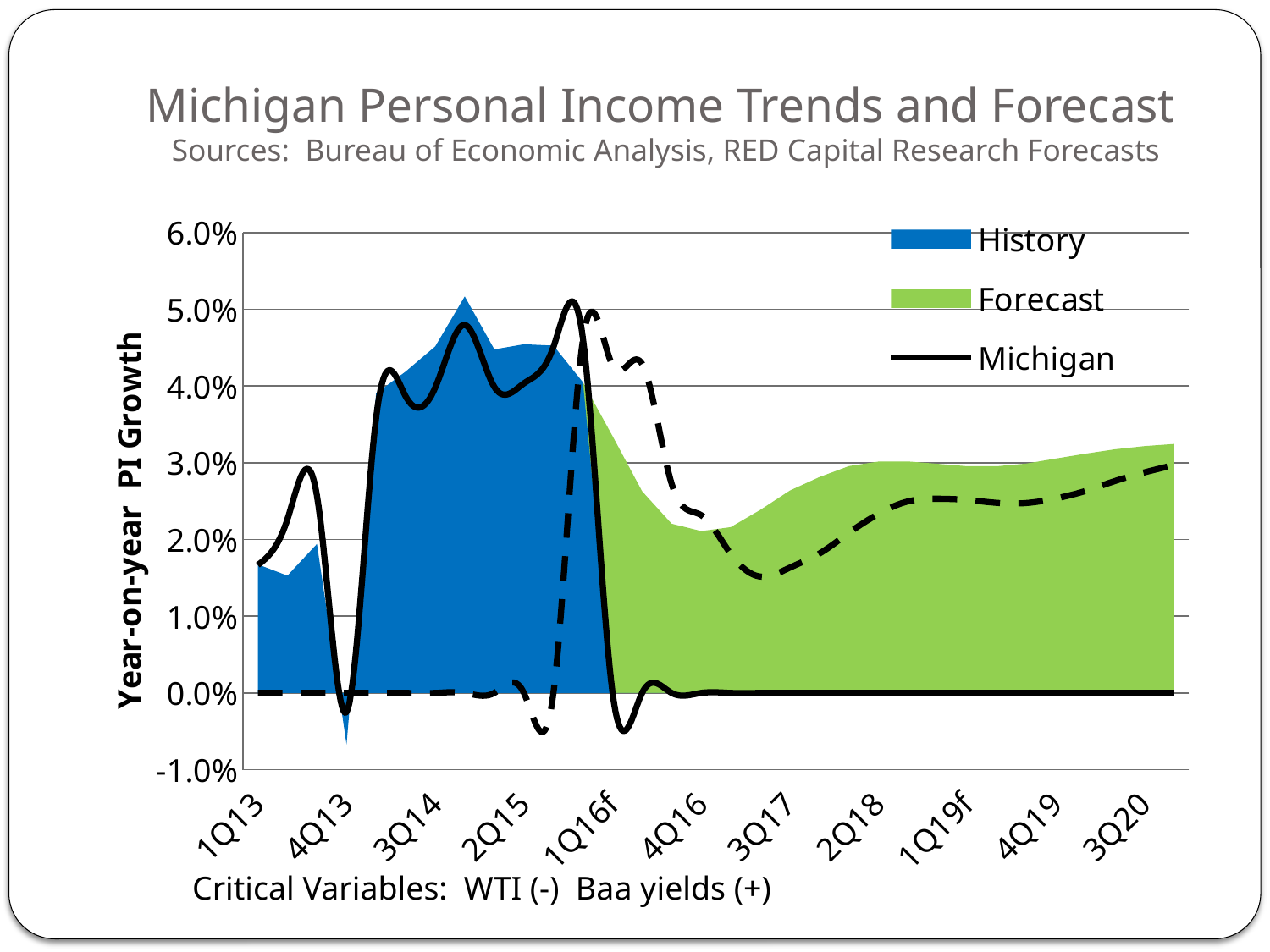
How many entries does the chart legend list? 3 Which is larger, the History value at 3Q14 or the History value at 1Q13? 3Q14 How many category labels are shown along the x axis? 11 Is the Forecast value at 3Q20 greater or less than 3.0%? greater Is the History value at 3Q14 greater or less than 4.0%? greater Is the History value at 1Q13 greater or less than 2.0%? less What is the label on the vertical axis? Year-on-year PI Growth What kind of chart is shown on the slide? Area chart with a line What is the title of the chart? Michigan Personal Income Trends and Forecast Does the Forecast area rise or fall from 3Q17 to 3Q20? rise What is the highest tick value shown on the vertical axis? 6.0%